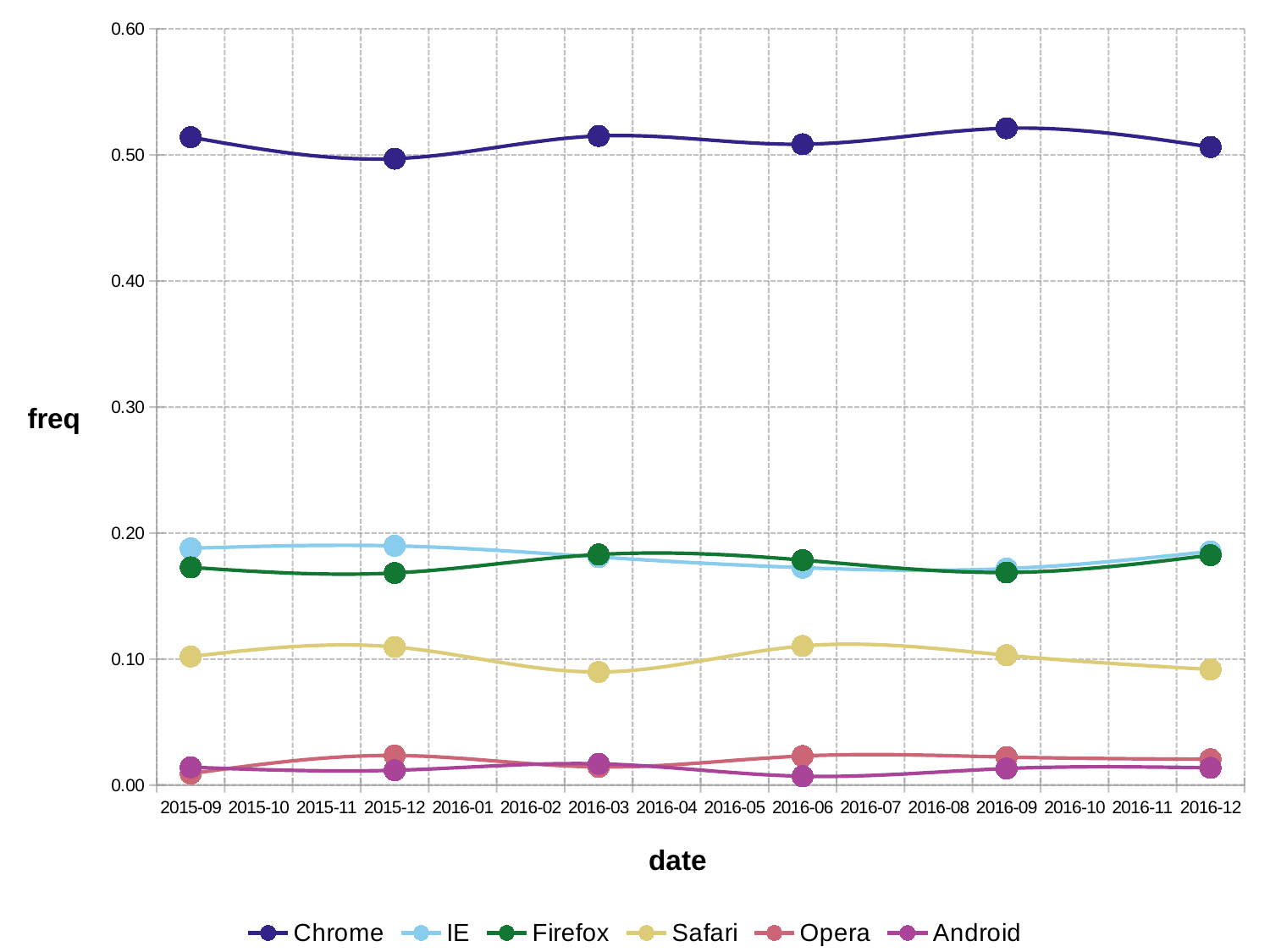
Is the value for IE at 2015-12 greater or less than 0.20? less How many data points are plotted for the Chrome series? 6 Which series has the lowest value at 2016-06? Android Does the Safari series rise or fall from 2016-06 to 2016-12? fall What kind of chart is shown on the slide? line chart Which is larger at 2016-06, the value for Opera or the value for Android? Opera Is the value for Chrome at 2016-09 greater or less than 0.50? greater What is the label on the vertical axis? freq Which is larger at 2016-03, the value for Firefox or the value for Safari? Firefox Which series has the highest values across the whole chart? Chrome How many series does the legend list? 6 Is the value for Safari at 2016-03 greater or less than 0.10? less